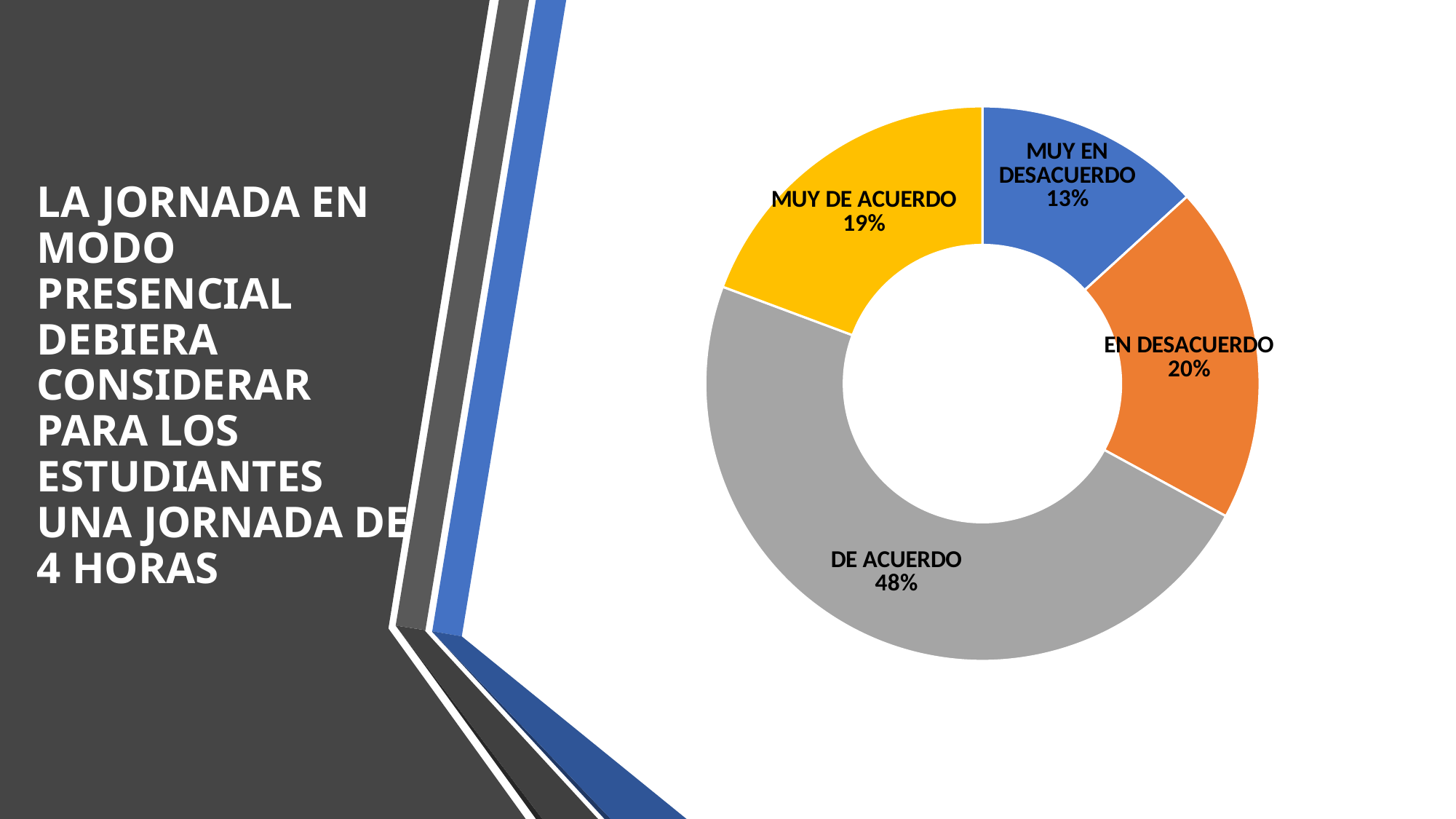
Which category has the smallest share of the chart? MUY EN DESACUERDO What percentage of respondents answered EN DESACUERDO? 20% What percentage of respondents answered MUY DE ACUERDO? 19% What colour is the DE ACUERDO segment of the chart? Grey What kind of chart is shown on the slide? Doughnut chart What is the difference in percentage points between DE ACUERDO and EN DESACUERDO? 28 Which category has the largest share of the chart? DE ACUERDO How many categories are shown in the chart? 4 What is the combined percentage of DE ACUERDO and MUY DE ACUERDO? 67% What percentage of respondents answered DE ACUERDO? 48% What percentage of respondents answered MUY EN DESACUERDO? 13% Which is larger, the share for EN DESACUERDO or the share for MUY DE ACUERDO? EN DESACUERDO